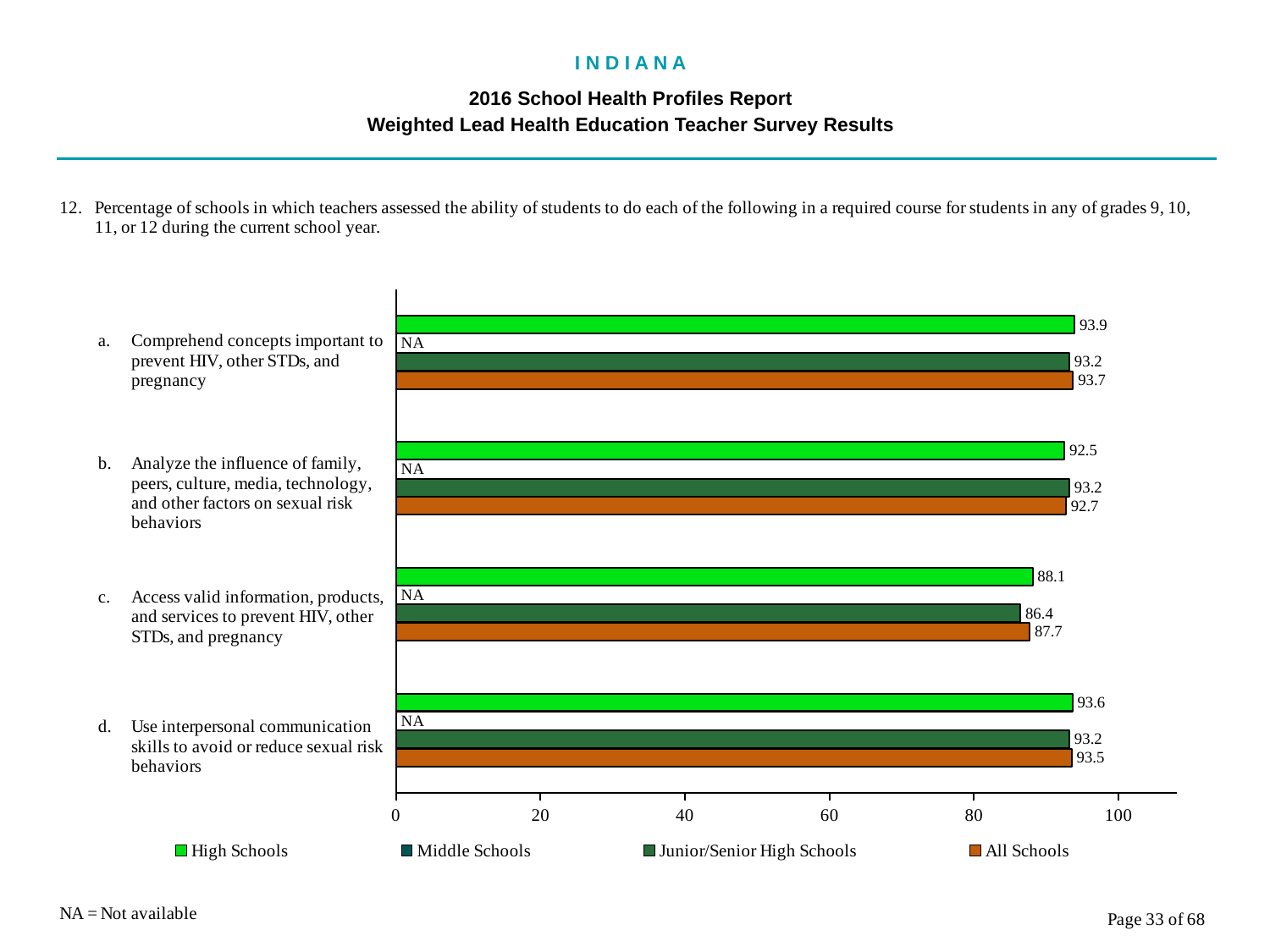
What kind of chart is shown on the slide? Bar chart Which item has the highest High Schools value? a. Comprehend concepts important to prevent HIV, other STDs, and pregnancy How many items (categories) are plotted on the chart? 4 How many series does the legend list? 4 What is the High Schools value for item a, comprehend concepts important to prevent HIV, other STDs, and pregnancy? 93.9 Which item has the lowest High Schools value? c. Access valid information, products, and services to prevent HIV, other STDs, and pregnancy What is the All Schools value for item c, access valid information, products, and services to prevent HIV, other STDs, and pregnancy? 87.7 What is the Junior/Senior High Schools value for item b, analyze the influence of family, peers, culture, media, technology, and other factors on sexual risk behaviors? 93.2 What is the difference between the High Schools value and the Junior/Senior High Schools value for item c? 1.7 What value is shown for Middle Schools for item d, use interpersonal communication skills to avoid or reduce sexual risk behaviors? NA For item b, which is larger: the High Schools value or the Junior/Senior High Schools value? Junior/Senior High Schools What does NA stand for according to the note on the slide? Not available